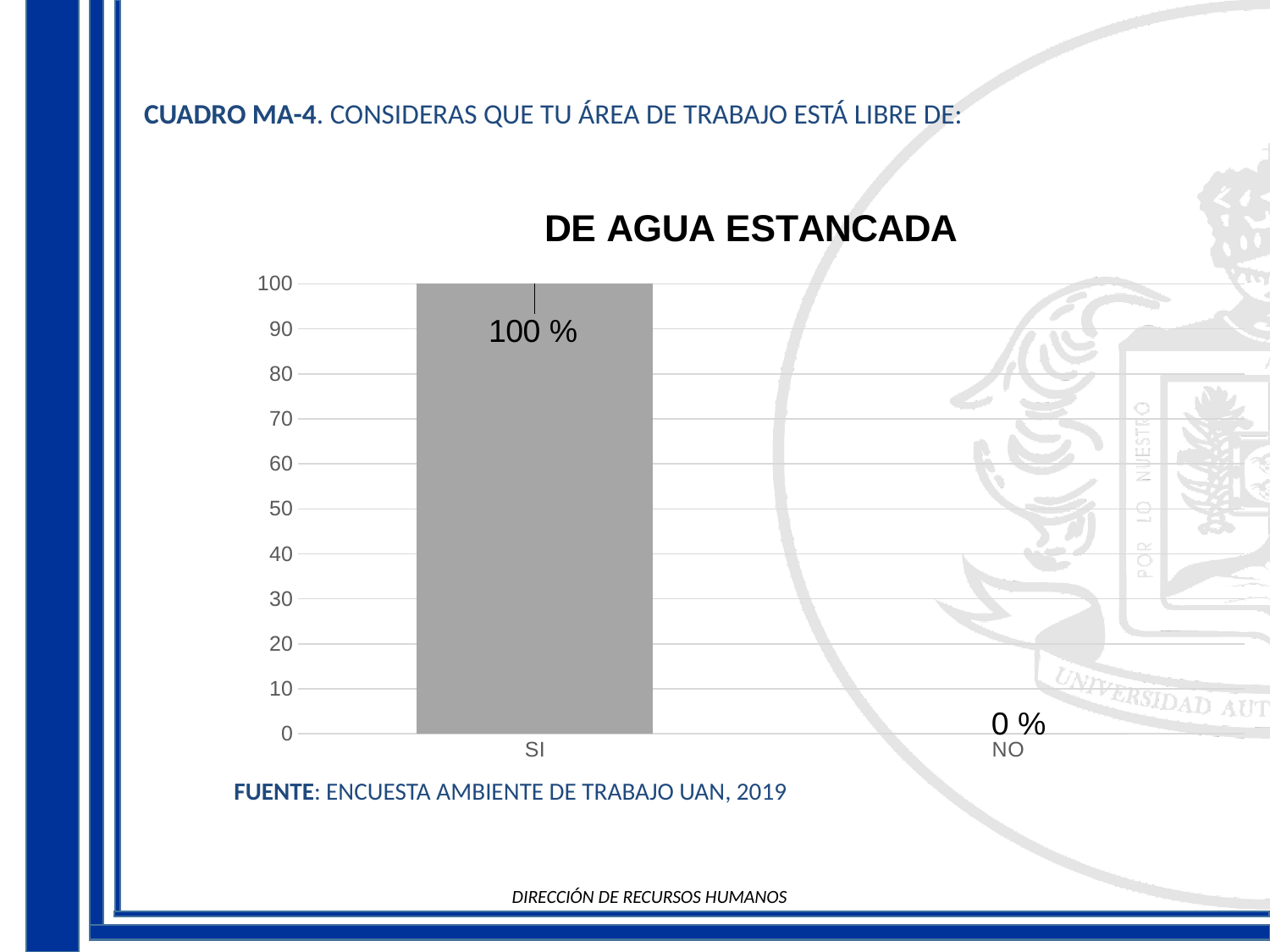
What is the title of the chart? DE AGUA ESTANCADA What is the difference between the values for SI and NO? 100 % How many categories are shown on the x axis? 2 What kind of chart is this? bar chart Which is larger, the value for SI or the value for NO? SI Do the values rise or fall from SI to NO? fall What is the highest value shown on the vertical axis? 100 What is the value for NO? 0 % Which category has the lowest value? NO Which category has the highest value? SI What is the value for SI? 100 % Is the value for SI greater or less than 50? greater